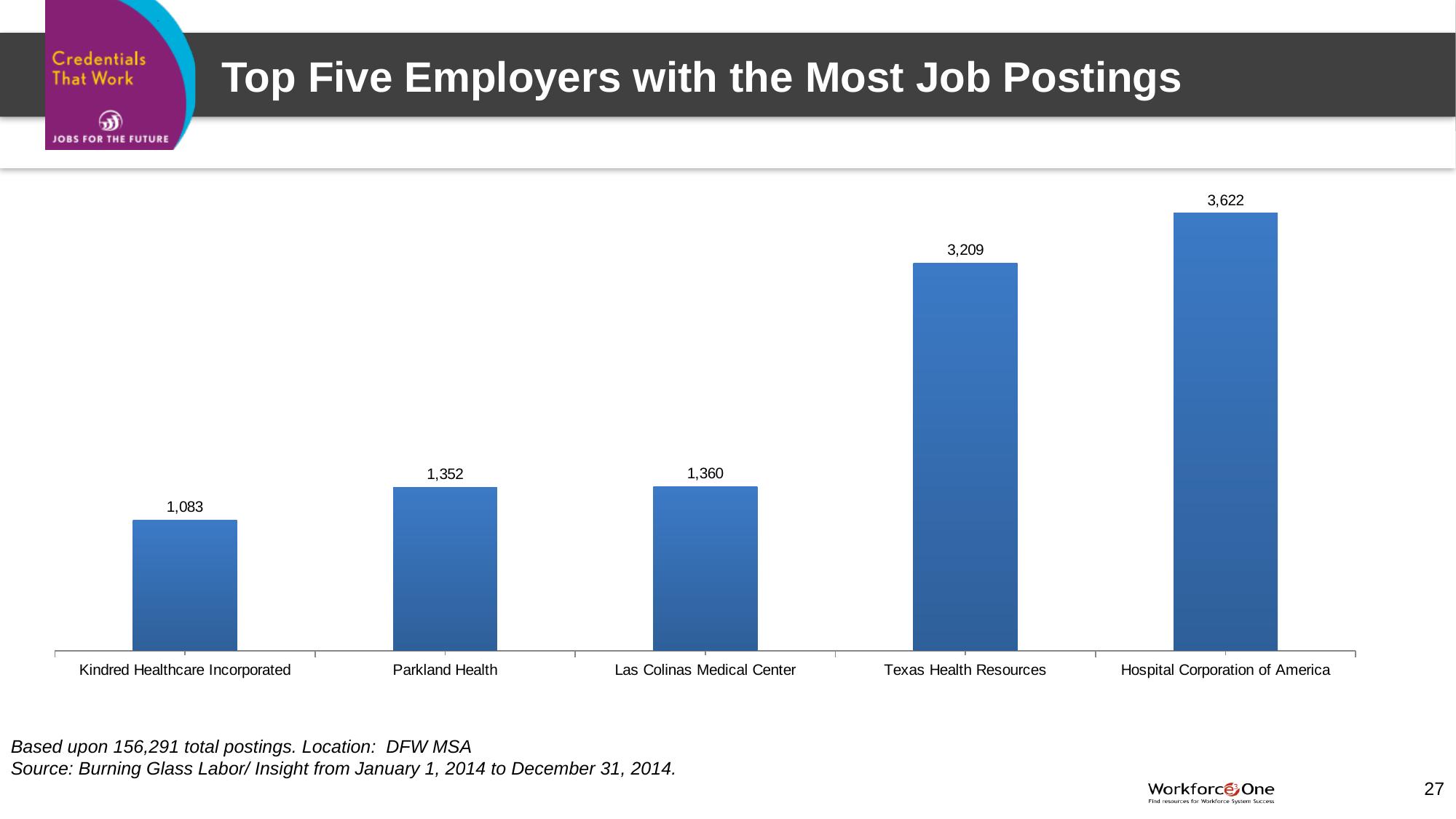
What is the difference between Hospital Corporation of America and Texas Health Resources? 413 How many job postings does Hospital Corporation of America have? 3,622 What is the title of the slide? Top Five Employers with the Most Job Postings Which employer has the most job postings? Hospital Corporation of America What is the value shown for Texas Health Resources? 3,209 What is the value shown for Parkland Health? 1,352 What is the value shown for Kindred Healthcare Incorporated? 1,083 How many employers are shown in the chart? 5 Which has more job postings, Texas Health Resources or Parkland Health? Texas Health Resources What is the difference between Las Colinas Medical Center and Parkland Health? 8 Which employer has the fewest job postings? Kindred Healthcare Incorporated What kind of chart is shown on the slide? Bar chart